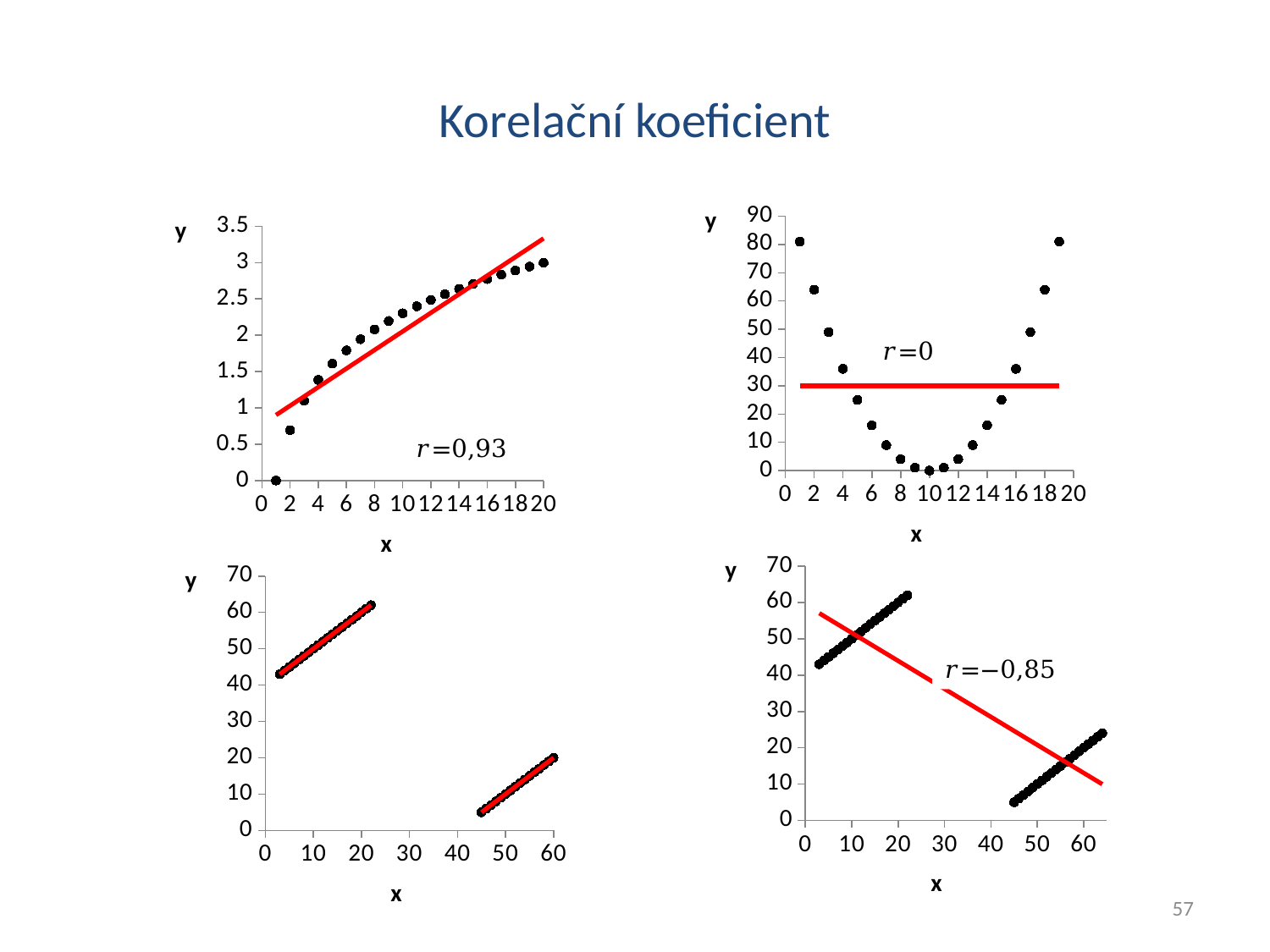
What is the title of the slide? Korelační koeficient How many charts are shown on the slide? 4 In the top-left chart, what correlation coefficient r is printed? r=0,93 In the top-right chart, at which y value is the horizontal red line drawn? 30 In the bottom-right chart, does the red trend line rise or fall as x increases? fall What kind of chart is the top-left chart? scatter chart In the top-right chart, is the y value at x=1 greater or less than 70? greater In the top-left chart, do the y values rise or fall as x increases? rise In the bottom-left chart, is the y value at x=50 greater or less than 20? less In the bottom-right chart, what correlation coefficient r is printed? r=−0,85 In the top-right chart, what correlation coefficient r is printed? r=0 In the top-left chart, is the y value at x=20 greater or less than 2.5? greater